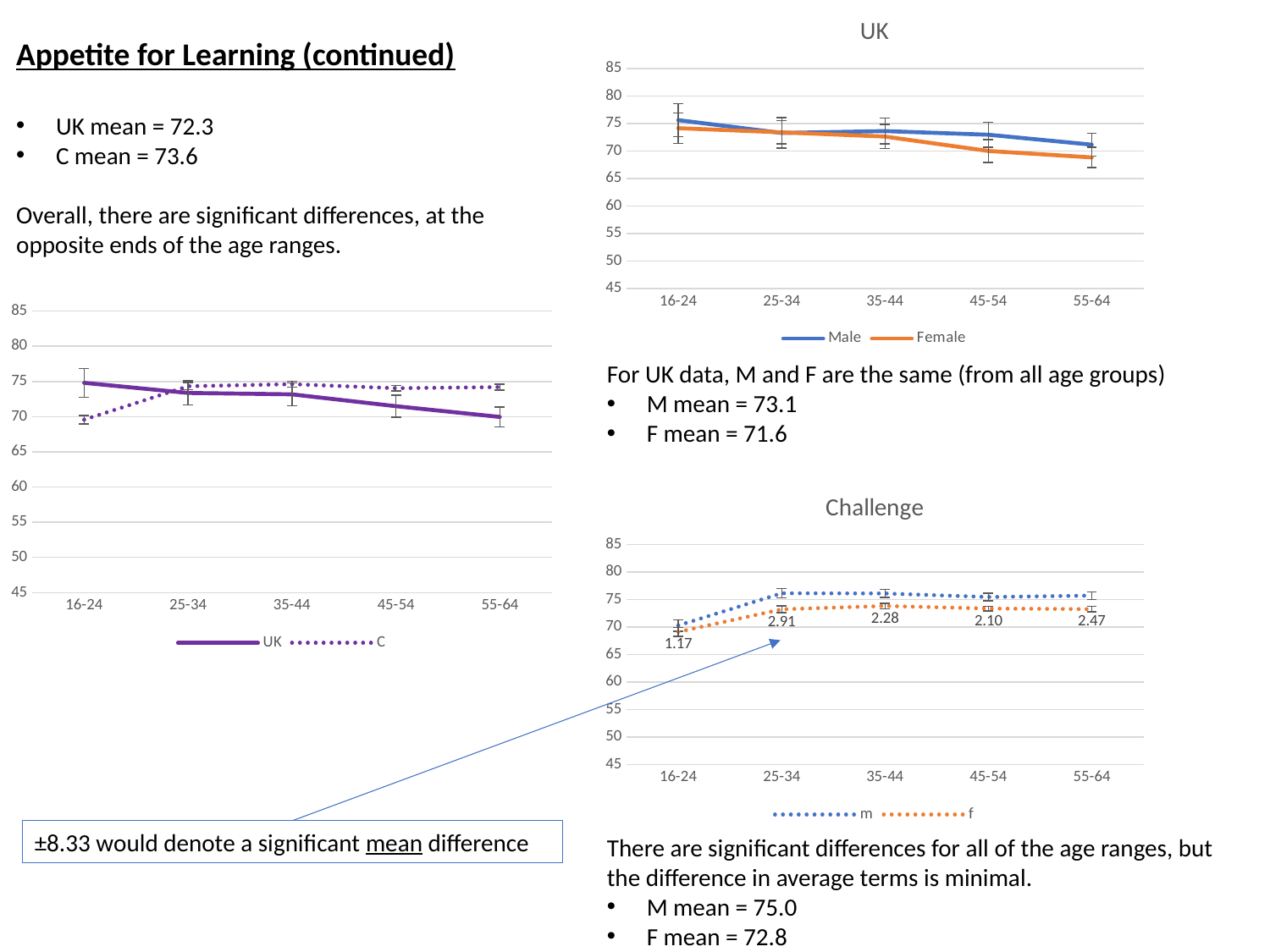
In the left-hand chart, does the UK series rise or fall from 16-24 to 55-64? fall In the left-hand chart, which age group has the highest UK value? 16-24 In the chart titled 'Challenge', is the m value for 16-24 greater or less than 75? less In the chart titled 'UK', which age group has the lowest Female value? 55-64 What kind of chart is the chart titled 'UK'? line chart In the left-hand chart, which series has the larger value at 55-64, UK or C? C In the chart titled 'UK', is the Male value for 55-64 greater or less than 75? less What are the two legend entries of the chart titled 'UK'? Male and Female In the left-hand chart, is the UK value for 55-64 greater or less than 75? less How many age groups are shown on the x axis of the chart titled 'Challenge'? 5 In the chart titled 'Challenge', which series has the larger value at 25-34, m or f? m How many series does the legend of the left-hand chart list? 2